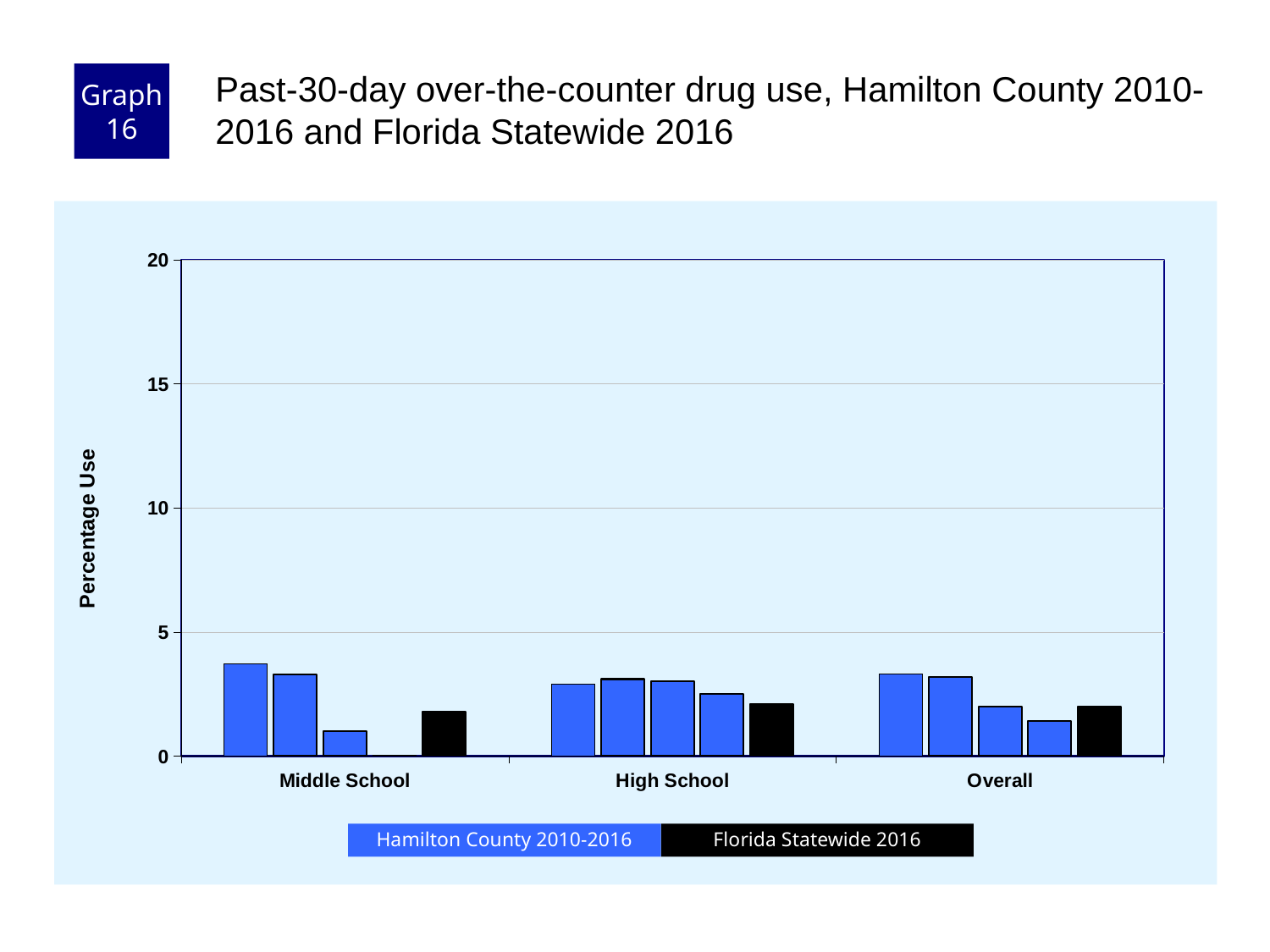
How many categories are shown on the x axis? 3 How many series does the legend list? 2 Is the tallest Hamilton County 2010-2016 bar for Middle School greater or less than 5? less Is the Florida Statewide 2016 value for Overall greater or less than 5? less Which category has the most Hamilton County 2010-2016 bars: Middle School or High School? High School Is the Florida Statewide 2016 value for High School greater or less than 5? less Do the Hamilton County 2010-2016 bars for Overall rise or fall from left to right? fall What is the label of the y axis? Percentage Use What is the highest value shown on the y axis? 20 What kind of chart is shown on the slide? bar chart